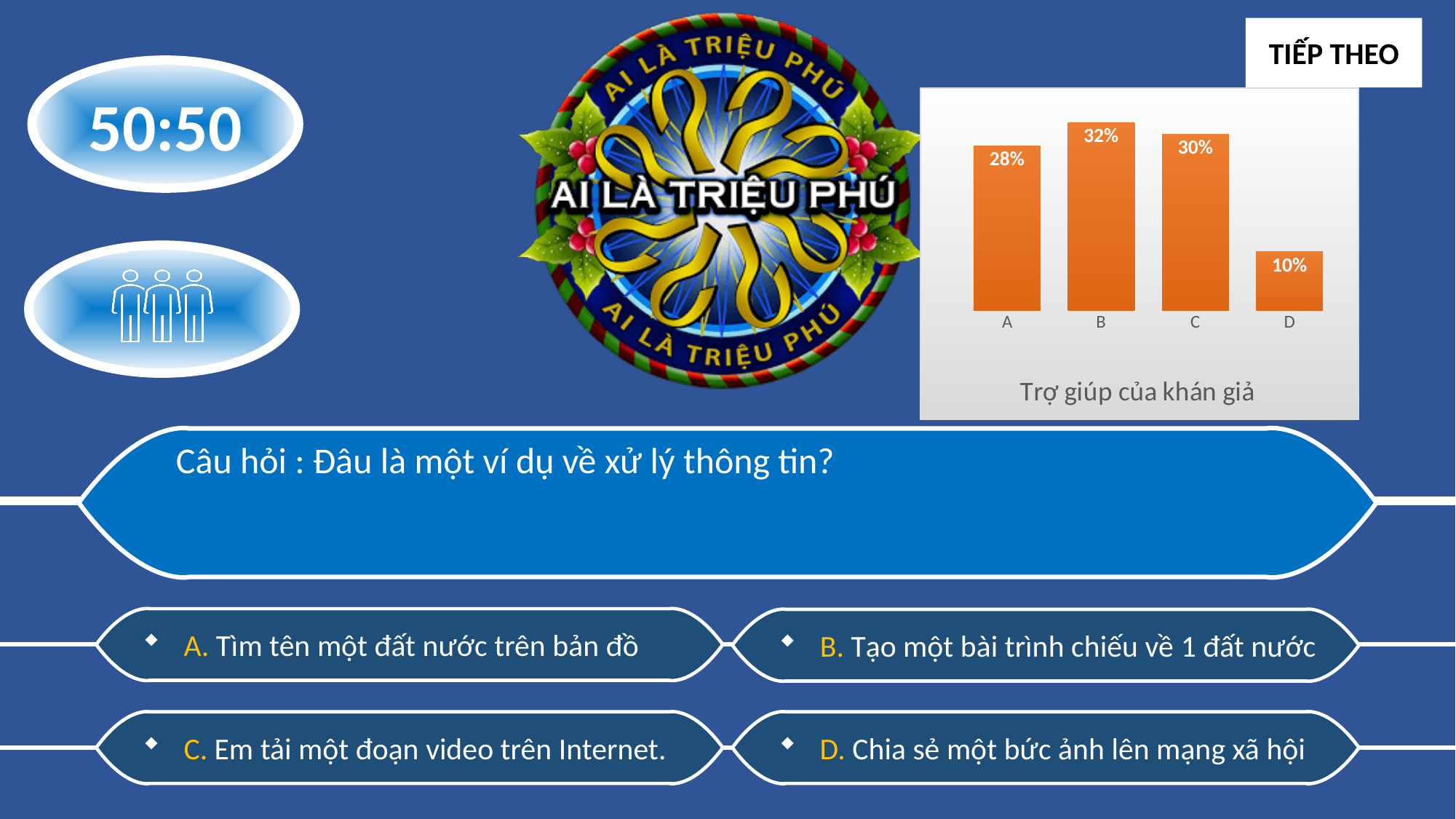
What kind of chart is shown on the slide? Bar chart Which is larger, the value for A or the value for D? A What is the title of the chart? Trợ giúp của khán giả What is the value for category D in the chart? 10% What is the value for category C in the chart? 30% Which category has the lowest value in the chart? D Which category has the highest value in the chart? B How many categories are shown in the chart? 4 What is the value for category A in the chart? 28% What is the difference between the values for C and A? 2% What is the difference between the values for B and D? 22% What is the value for category B in the chart? 32%